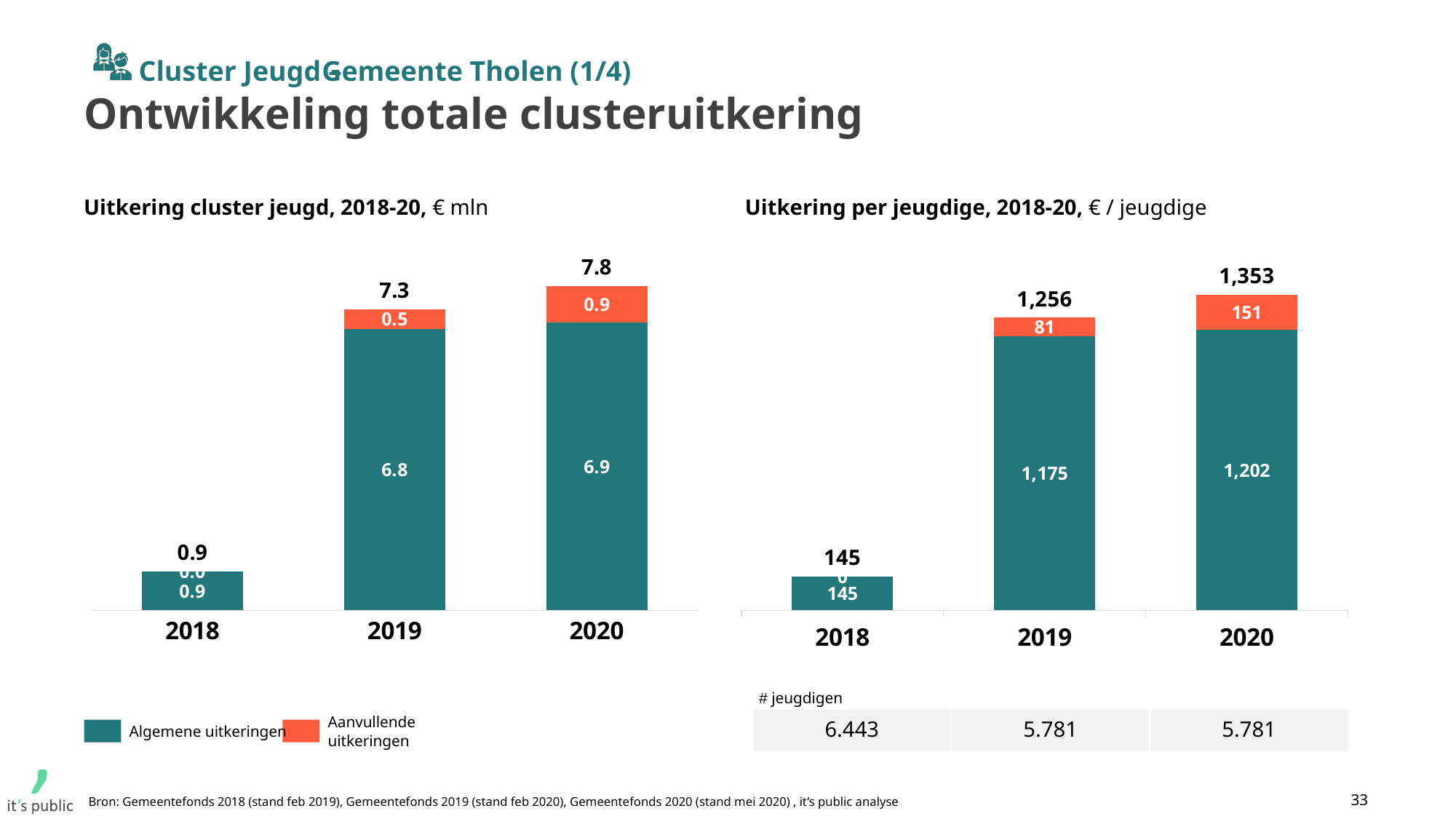
In the chart 'Uitkering per jeugdige, 2018-20', is the total for 2019 larger or smaller than the total for 2018? larger In the chart 'Uitkering per jeugdige, 2018-20', which year has the highest total? 2020 In the chart 'Uitkering per jeugdige, 2018-20', what is the difference between the 2020 total and the 2019 total? 97 In the chart 'Uitkering cluster jeugd, 2018-20', what is the value of Algemene uitkeringen for 2019? 6.8 What kind of chart is 'Uitkering cluster jeugd, 2018-20'? Stacked bar chart In the chart 'Uitkering cluster jeugd, 2018-20', what is the difference between the 2020 total and the 2019 total? 0.5 In the chart 'Uitkering cluster jeugd, 2018-20', which year has the lowest total? 2018 How many series does the legend list for the charts on this slide? 2 In the chart 'Uitkering per jeugdige, 2018-20', what is the value of Algemene uitkeringen for 2020? 1,202 In the chart 'Uitkering per jeugdige, 2018-20', what is the value of Aanvullende uitkeringen for 2019? 81 In the chart 'Uitkering cluster jeugd, 2018-20', what is the total shown above the 2020 bar? 7.8 In the chart 'Uitkering cluster jeugd, 2018-20', what is the value of Aanvullende uitkeringen for 2020? 0.9